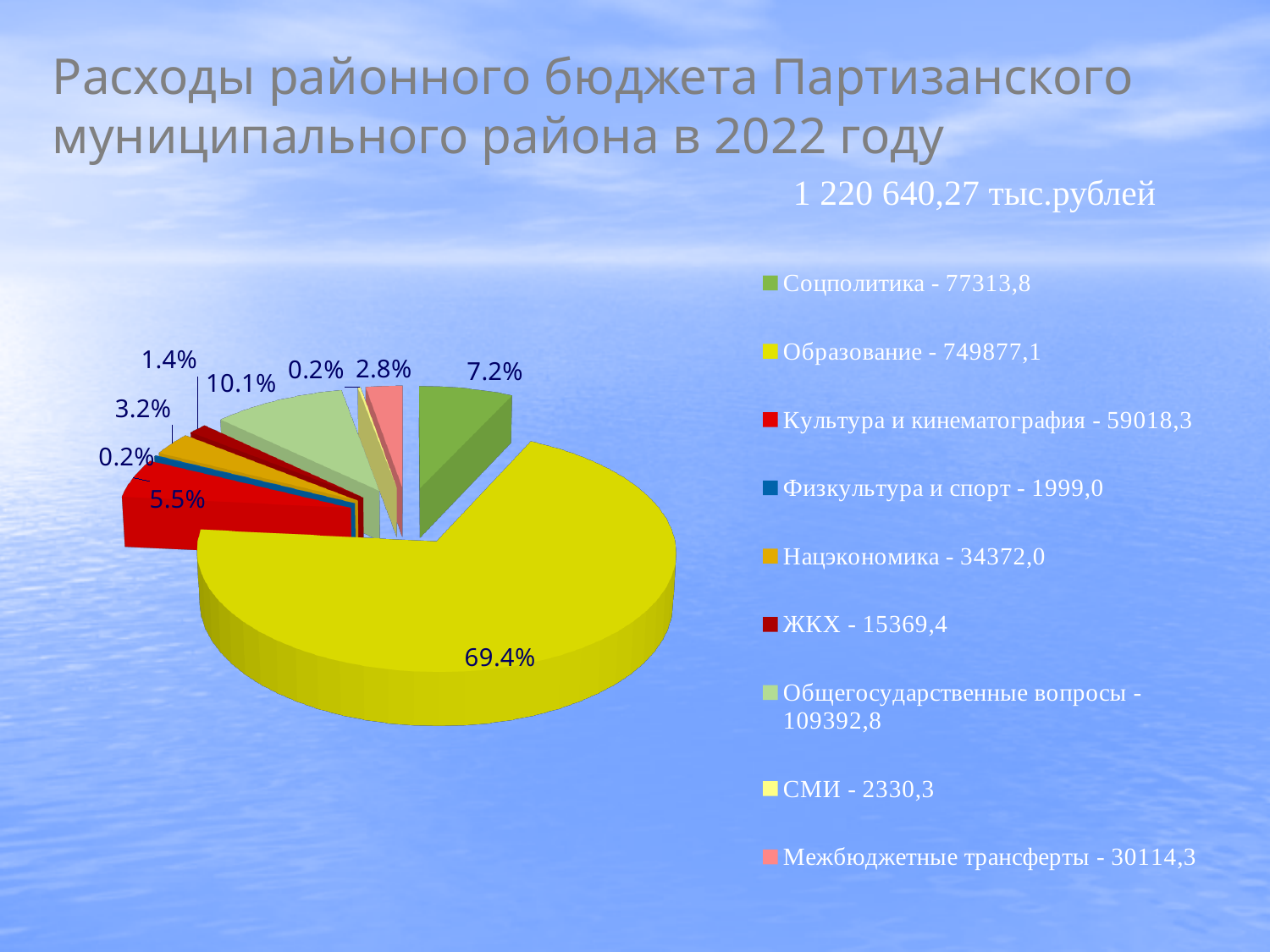
Which category has the largest slice of the pie? Образование What value is given for Межбюджетные трансферты in the legend? 30114,3 What is the difference between the values for Соцполитика and Культура и кинематография? 18295,5 Which is larger, the value for Нацэкономика or the value for ЖКХ? Нацэкономика What share of the pie does Образование take? 69.4% What type of chart is shown on the slide? pie chart What share of the pie does Общегосударственные вопросы take? 10.1% How many categories does the pie chart's legend list? 9 What total amount in thousand rubles is stated on the slide? 1 220 640,27 тыс.рублей What value is given for Культура и кинематография in the legend? 59018,3 What share of the pie does Соцполитика take? 7.2% What value is given for Физкультура и спорт in the legend? 1999,0